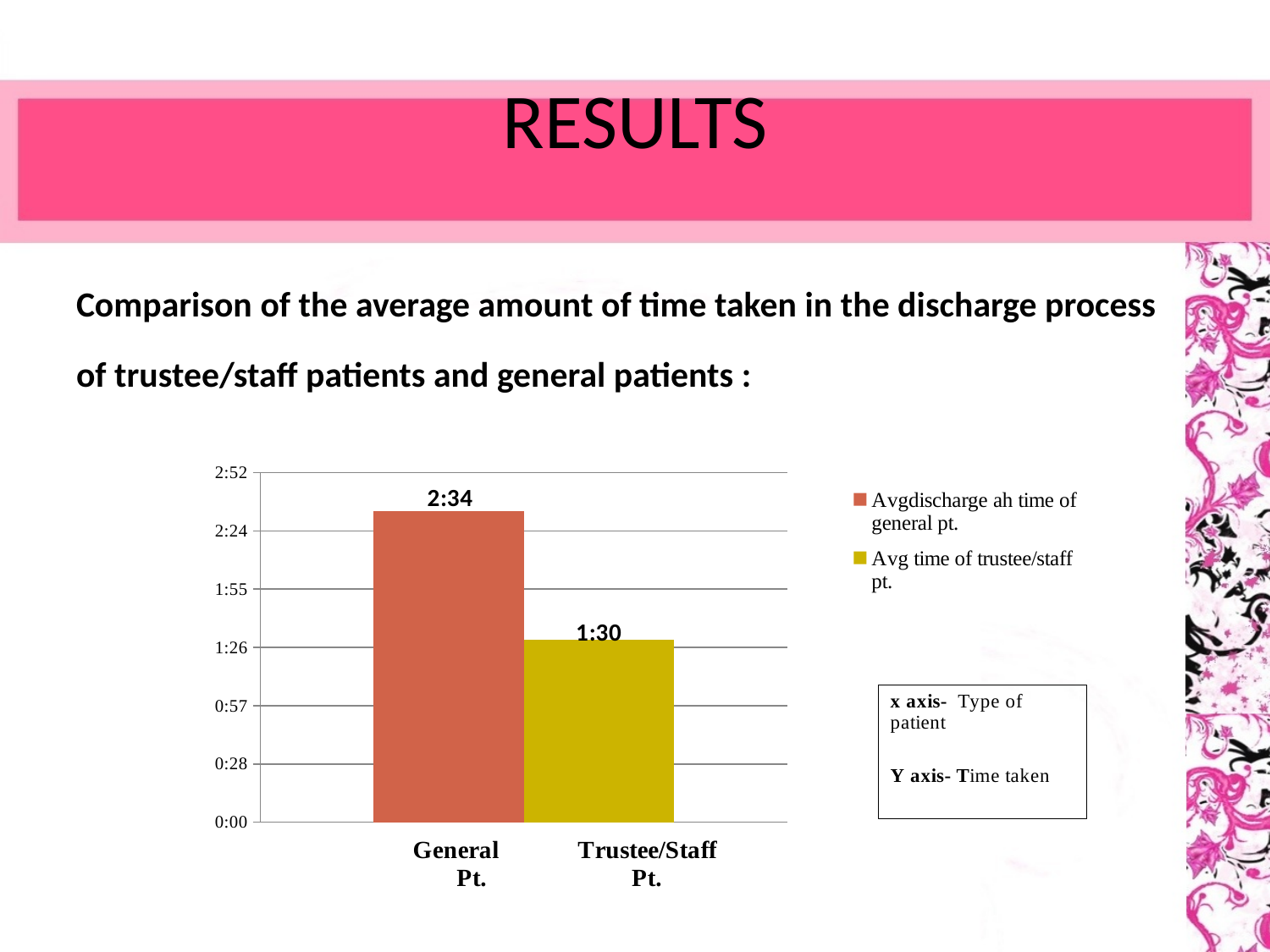
What is the difference between the values for General Pt. and Trustee/Staff Pt.? 1:04 How many categories are shown on the x axis? 2 What is the value shown for General Pt.? 2:34 Which category has the lowest value? Trustee/Staff Pt. According to the text box next to the chart, what does the Y axis represent? Time taken Which category has the highest value? General Pt. Is the value for General Pt. greater or less than 2:24? greater Which is larger, the value for General Pt. or the value for Trustee/Staff Pt.? General Pt. How many series does the legend list? 2 What is the value shown for Trustee/Staff Pt.? 1:30 What kind of chart is shown on the slide? Bar chart Is the value for Trustee/Staff Pt. greater or less than 1:55? less